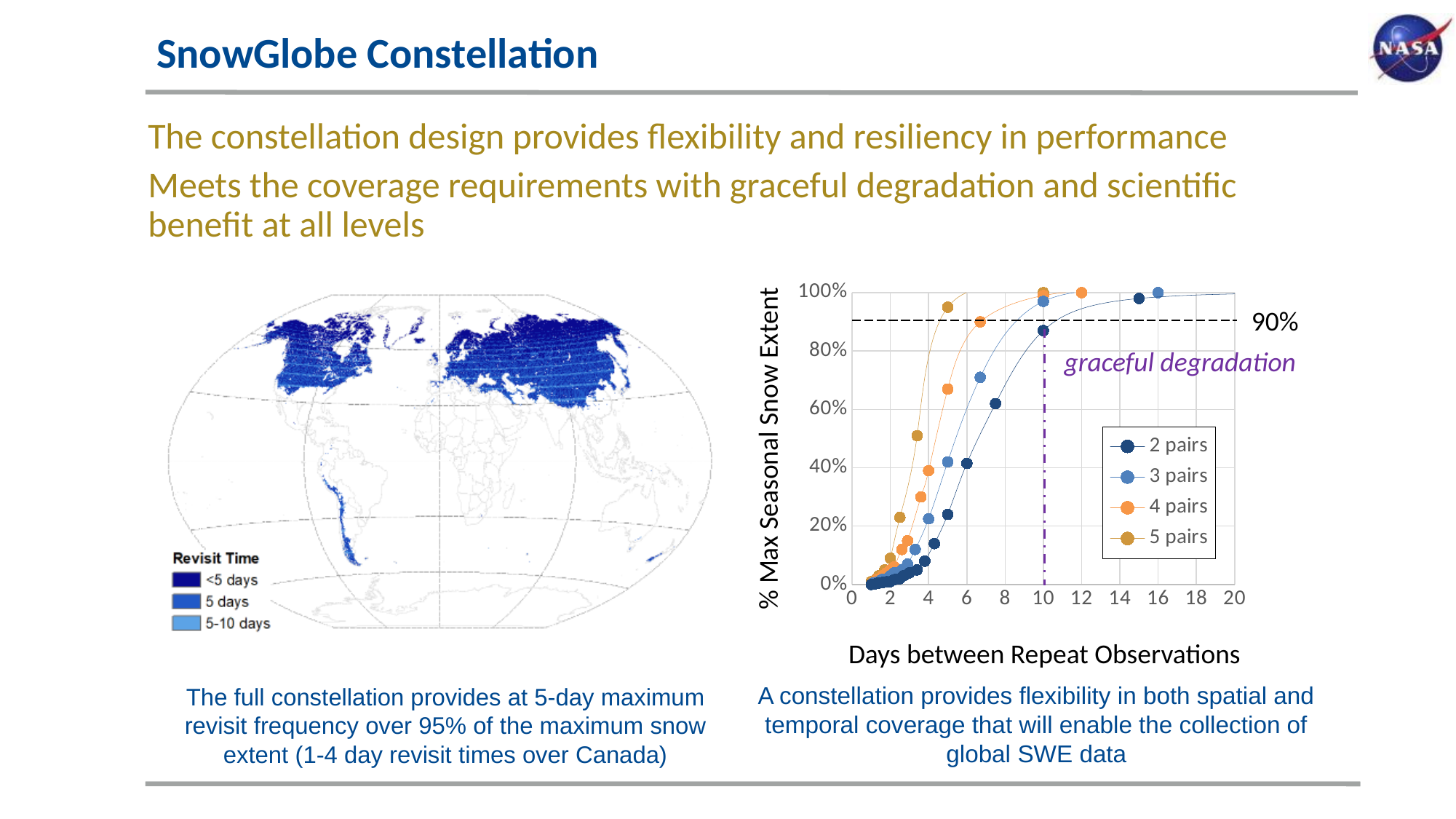
In the right-hand chart, which series takes the most days to reach 90%? 2 pairs How many series does the legend of the right-hand chart list? 4 What kind of chart is shown on the right side of the slide? Scatter chart with fitted lines What is the title of the x axis of the right-hand chart? Days between Repeat Observations In the right-hand chart, at 10 days between repeat observations, is the value for 3 pairs greater or less than 90%? greater In the right-hand chart, at 6 days between repeat observations, is the value for 4 pairs greater or less than 60%? greater In the right-hand chart, at 6 days between repeat observations, is the value for 2 pairs greater or less than 60%? less In the right-hand chart, at 6 days between repeat observations, which series has the higher value: 4 pairs or 2 pairs? 4 pairs In the right-hand chart, do the values for each series rise or fall as days between repeat observations increase? Rise In the right-hand chart, which series reaches 90% at the fewest days between repeat observations? 5 pairs What value does the horizontal dashed line on the right-hand chart mark? 90%